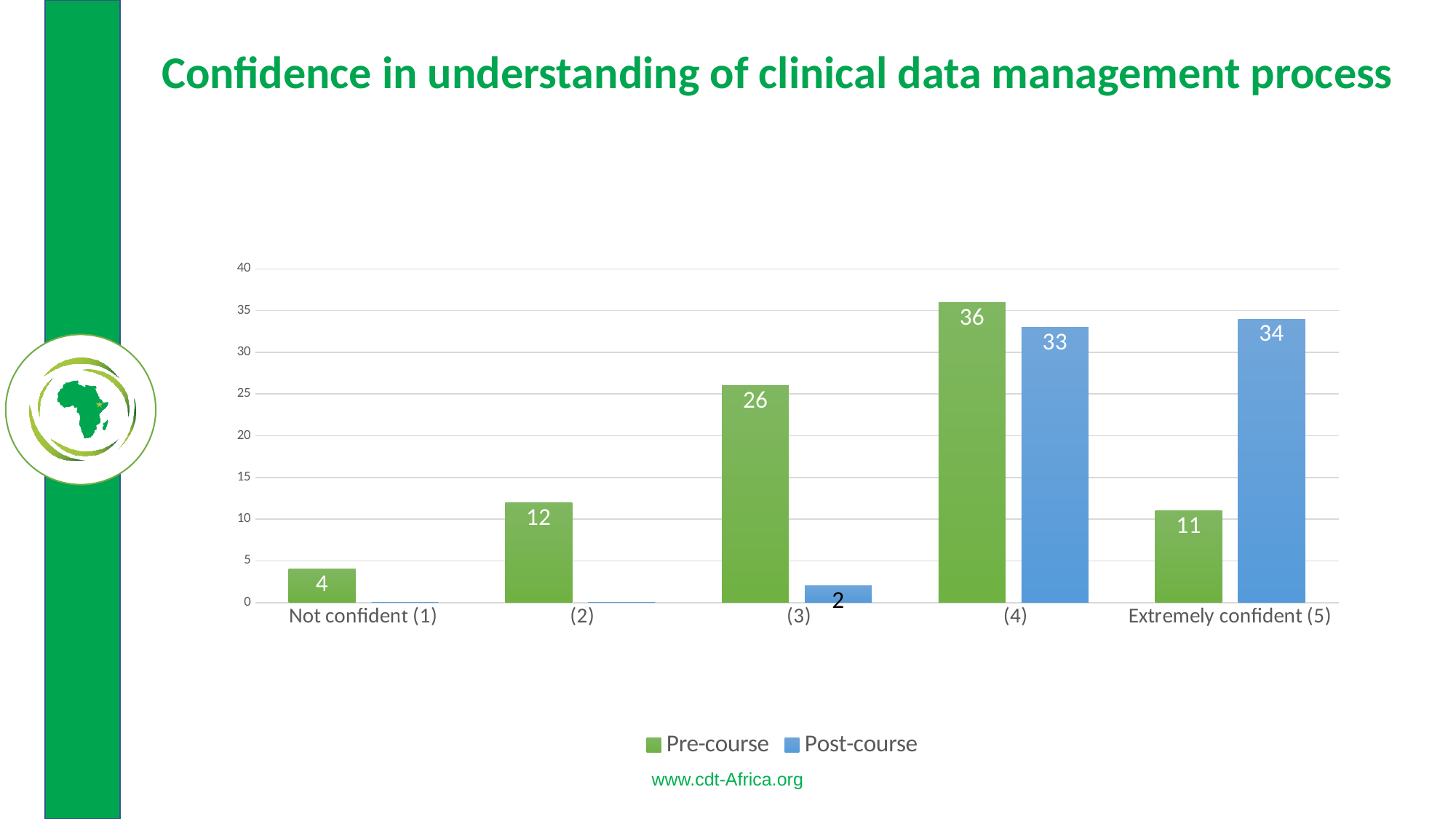
What is the Pre-course value for (3)? 26 Which is larger for (3): the Pre-course value or the Post-course value? Pre-course How many series does the legend list? 2 What is the title of the chart? Confidence in understanding of clinical data management process What is the Post-course value for Extremely confident (5)? 34 What is the Pre-course value for Not confident (1)? 4 What kind of chart is shown on the slide? Bar chart How many categories are shown on the x axis? 5 What is the Post-course value for (4)? 33 What is the difference between the Pre-course and Post-course values for Extremely confident (5)? 23 Which category has the highest Pre-course value? (4) Which category has the lowest Pre-course value? Not confident (1)